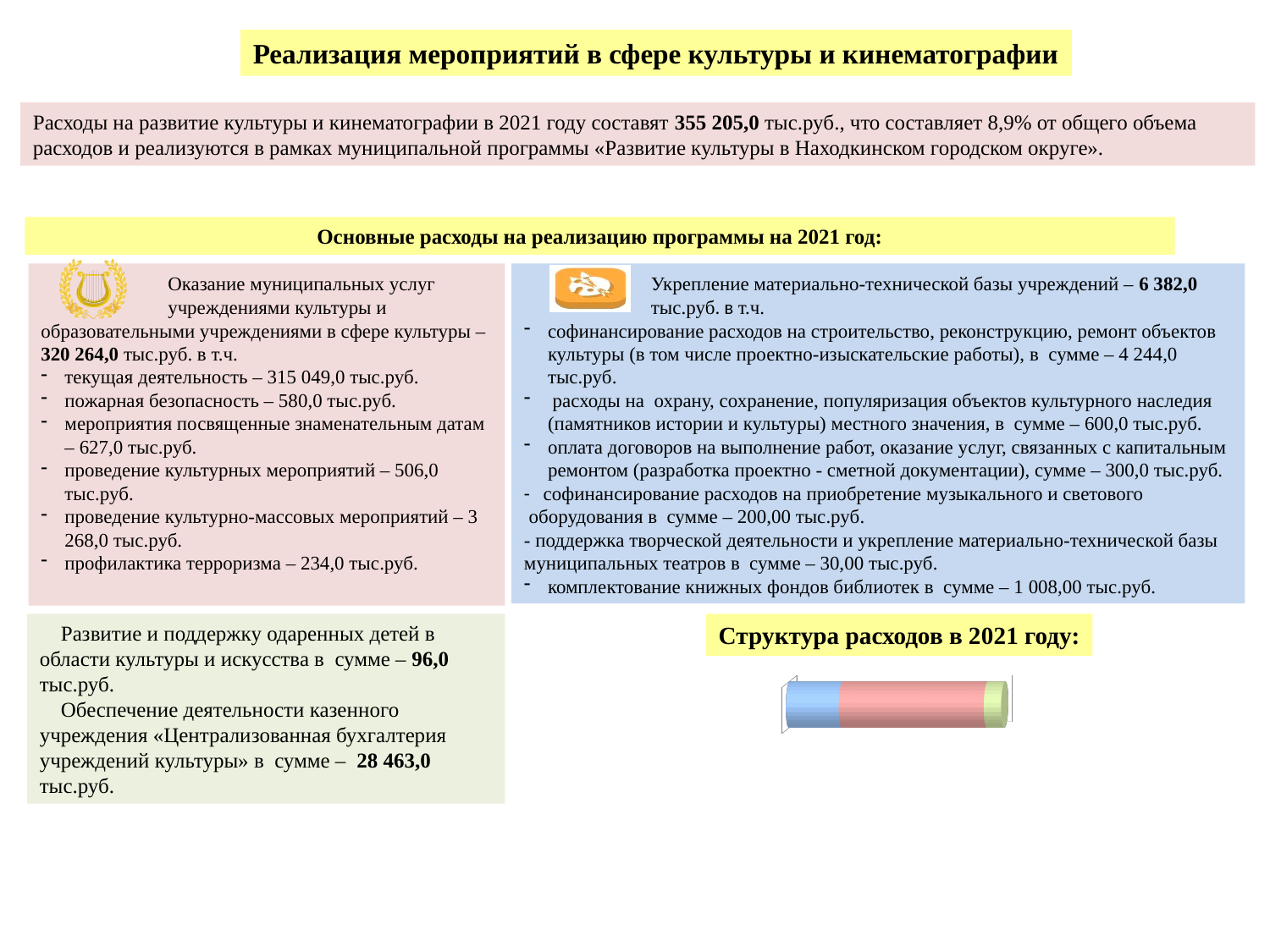
Is the blue segment of the stacked bar larger or smaller than the green segment? larger Is the pink segment of the stacked bar larger or smaller than the blue segment? larger Which coloured segment of the stacked bar is the largest? the pink (red) segment How many coloured segments make up the stacked bar in the chart? 3 What is the title above the chart on the slide? Структура расходов в 2021 году Is the stacked bar in the chart oriented horizontally or vertically? horizontally What kind of chart is shown under the heading "Структура расходов в 2021 году"? bar chart Which coloured segment of the stacked bar is the smallest? the green segment